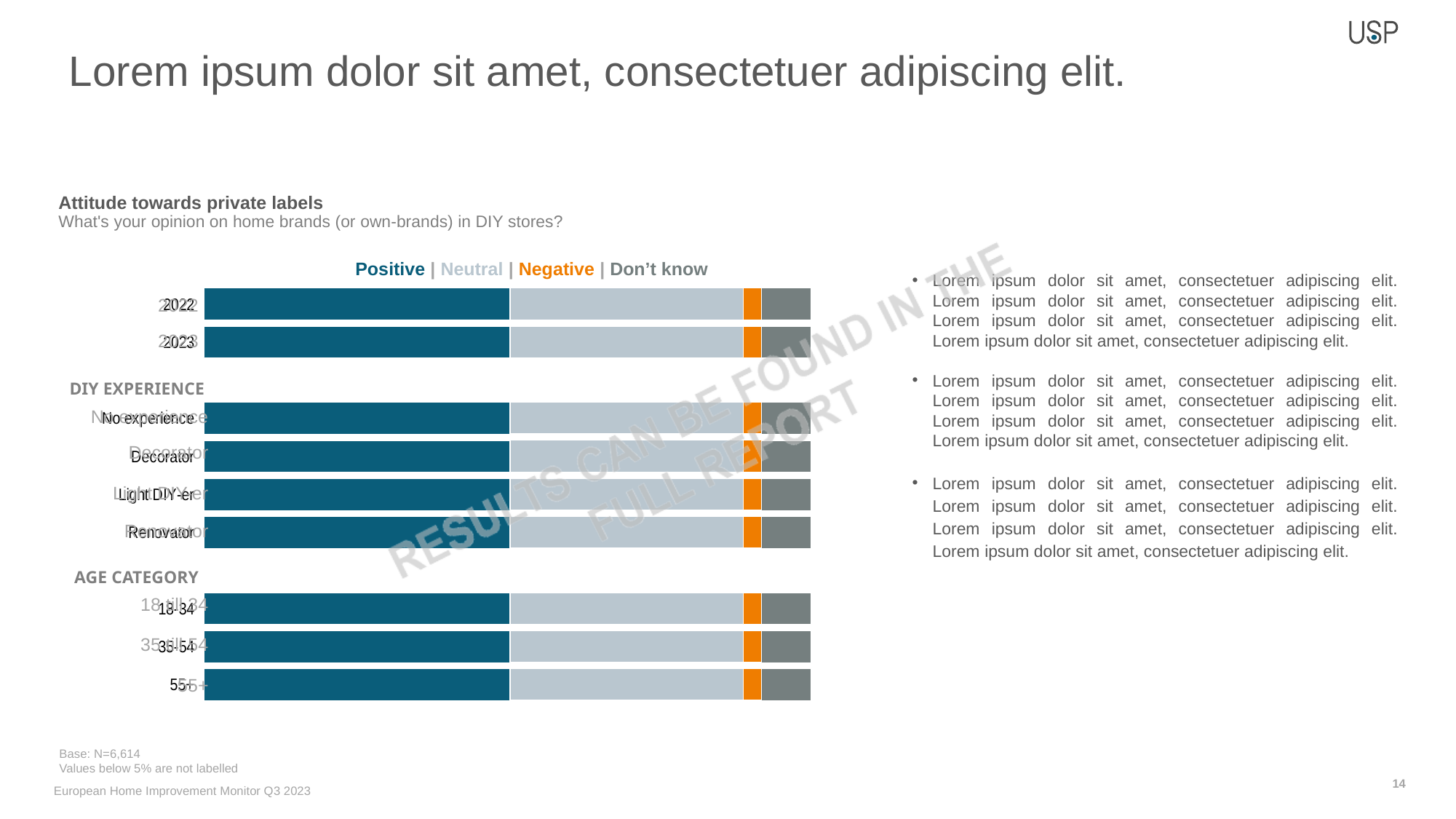
How many categories (bars) are plotted in the chart? 9 What is the title of the chart? Attitude towards private labels How many categories are listed under the AGE CATEGORY group in the chart? 3 Which series is shown in orange in the chart? Negative How many categories are listed under the DIY EXPERIENCE group in the chart? 4 What kind of chart is shown on the slide? Stacked bar chart In the Renovator bar, which segment is larger, Neutral or Don't know? Neutral In the 2022 bar, which segment is larger, Positive or Negative? Positive How many series does the chart legend list? 4 In the 55+ bar, which segment is smaller, Negative or Positive? Negative